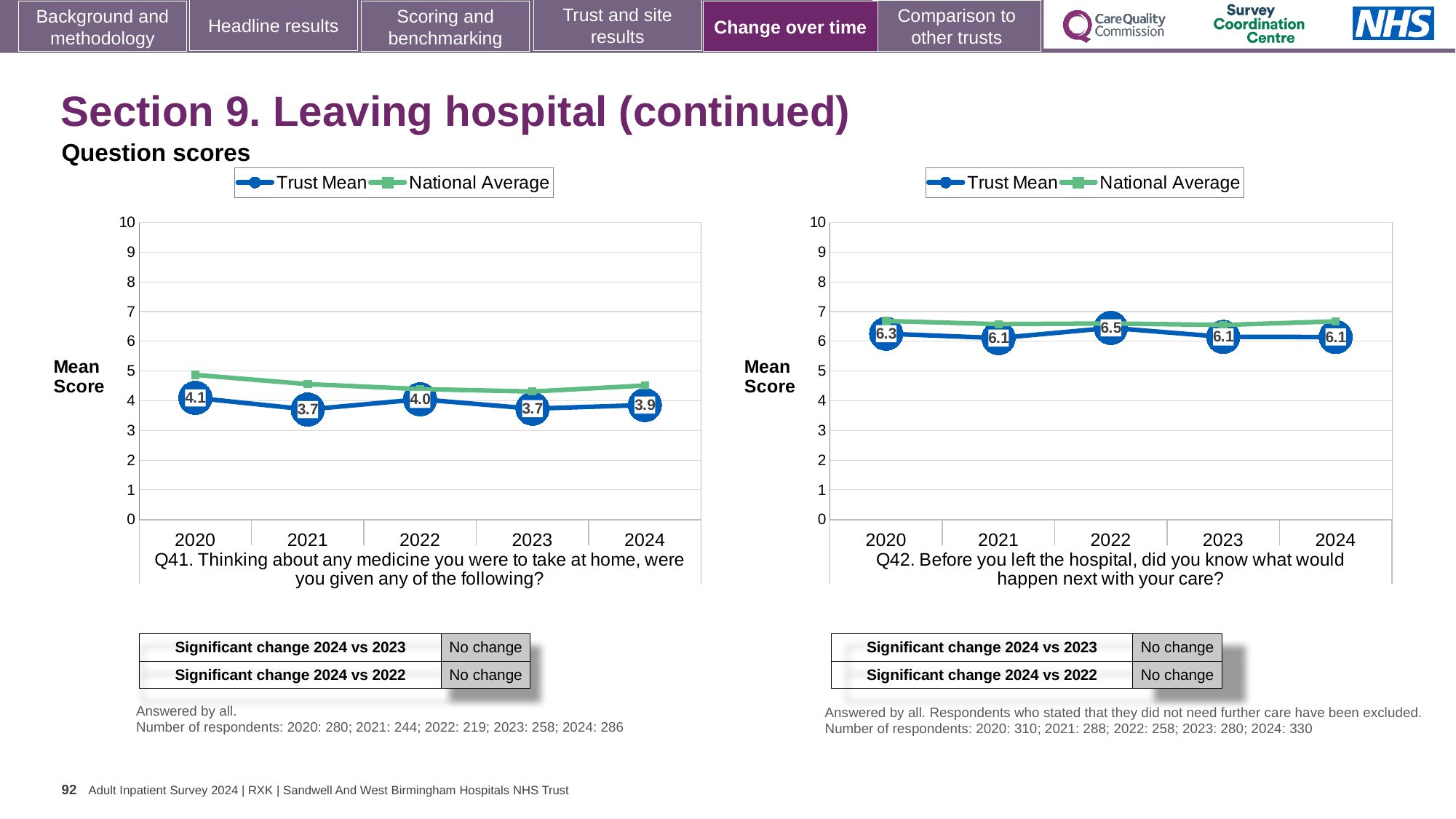
How many series does the legend of the Q42 chart (right) list? 2 In the Q41 chart (left), which year has the highest Trust Mean score? 2020 In the Q41 chart (left), what is the difference between the Trust Mean scores for 2020 and 2021? 0.4 In the Q41 chart (left), is the Trust Mean score for 2022 or 2023 larger? 2022 In the Q42 chart (right), which year has the highest Trust Mean score? 2022 What kind of chart is the Q41 chart (left)? Line chart In the Q42 chart (right), what is the difference between the Trust Mean scores for 2022 and 2023? 0.4 In the Q41 chart (left), what is the Trust Mean score for 2024? 3.9 In the Q42 chart (right), what is the Trust Mean score for 2022? 6.5 In the Q41 chart (left), what is the Trust Mean score for 2020? 4.1 In the Q42 chart (right), what is the Trust Mean score for 2024? 6.1 In the Q41 chart (left), is the National Average value for 2020 greater or less than 4? greater